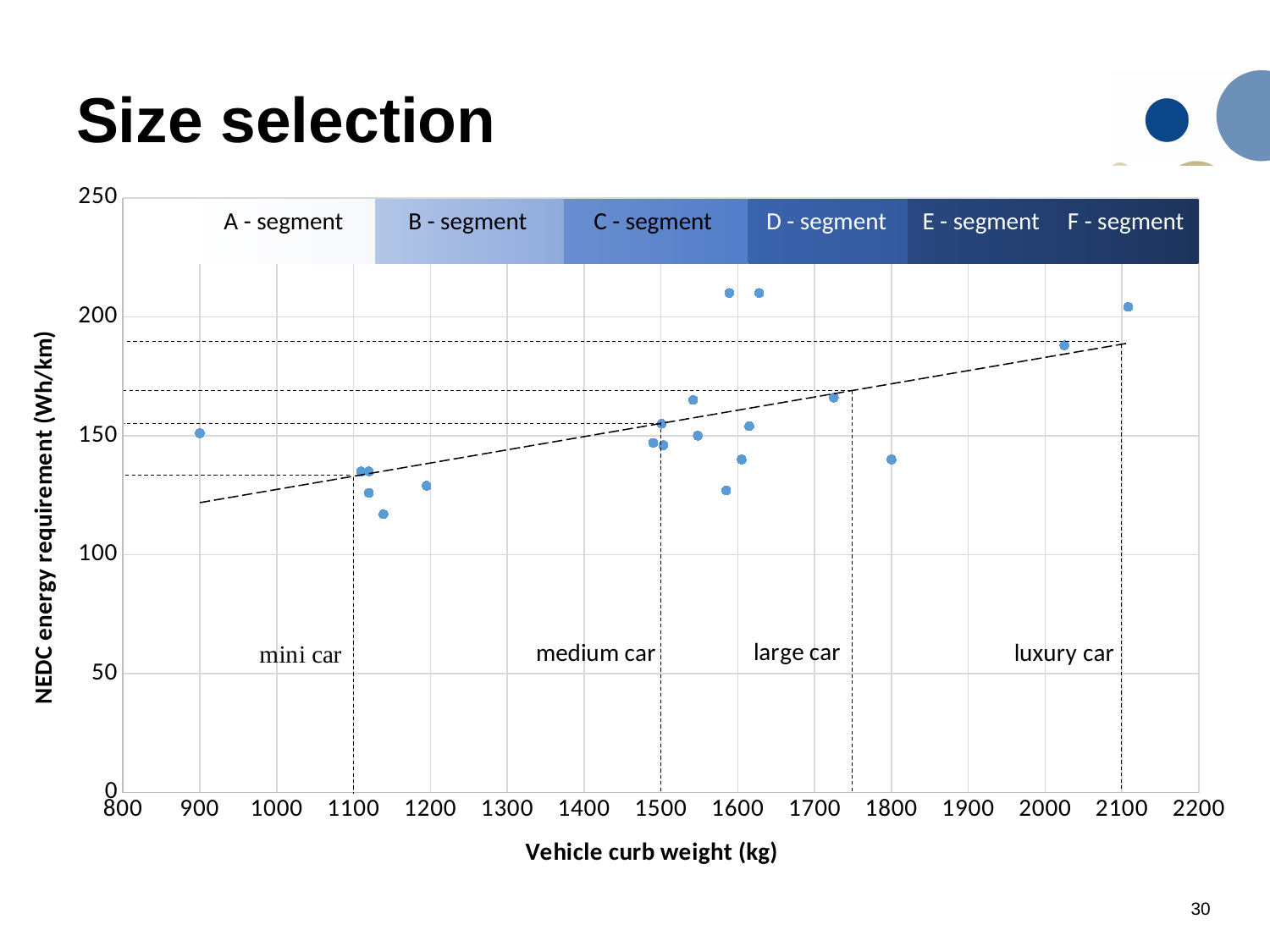
Is the NEDC energy requirement for the vehicle at about 2100 kg greater or less than 200 Wh/km? greater Is the NEDC energy requirement for the vehicle at about 1200 kg greater or less than 150 Wh/km? less What is the title of the x axis? Vehicle curb weight (kg) Is the NEDC energy requirement for the vehicle at about 1140 kg greater or less than 150 Wh/km? less How many vehicle segments (A to F) are labelled across the top of the chart? 6 How many car size classes (mini, medium, large, luxury) are labelled on the chart? 4 Which has the higher NEDC energy requirement: the vehicle at about 900 kg or the vehicle at about 2100 kg? the vehicle at about 2100 kg Which has the higher NEDC energy requirement: the vehicle at about 1800 kg or the vehicle at about 2025 kg? the vehicle at about 2025 kg What is the title of the y axis? NEDC energy requirement (Wh/km) What kind of chart is shown on the slide? scatter chart Does the NEDC energy requirement generally rise or fall as vehicle curb weight increases along the x axis? rise